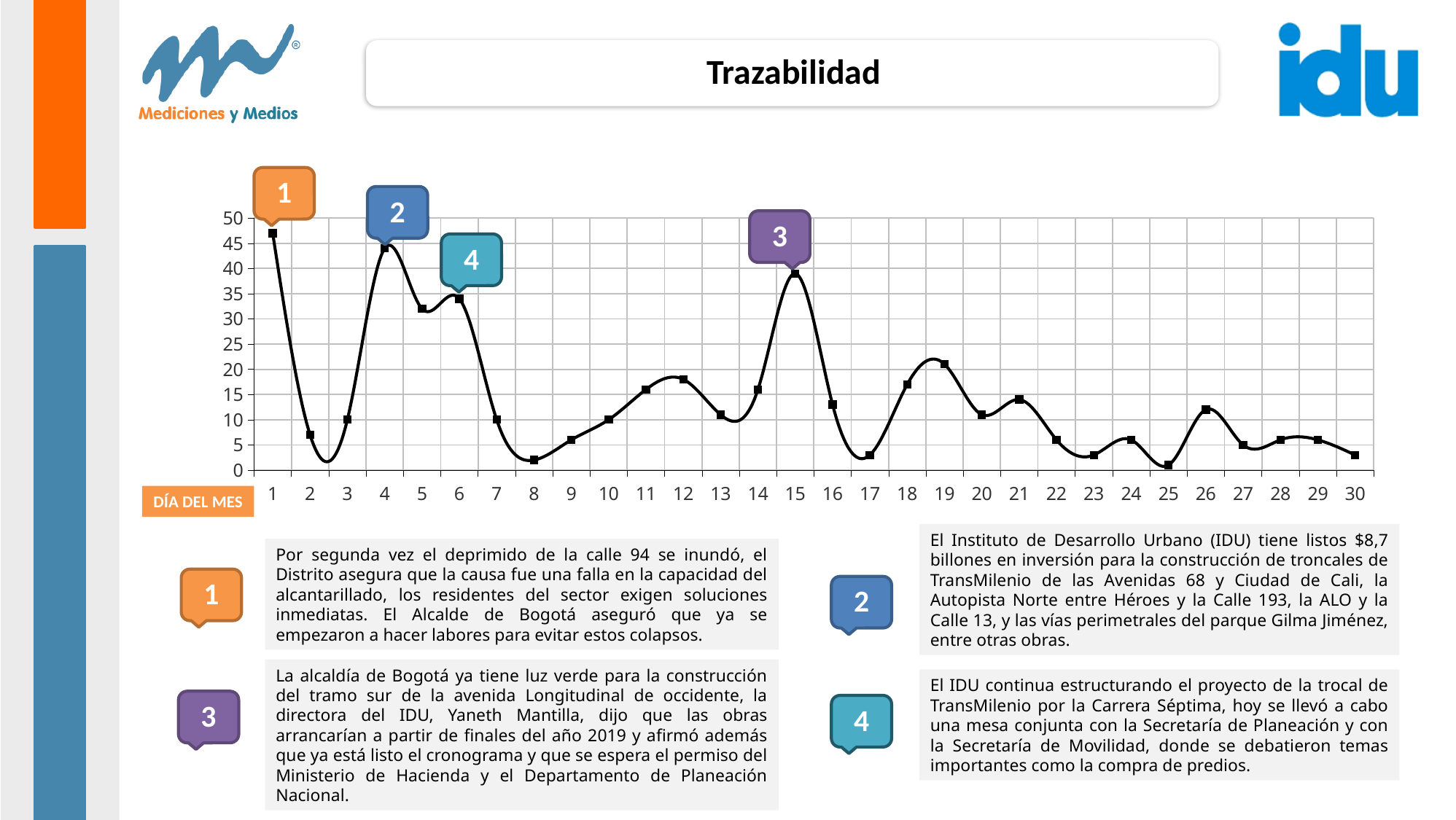
What label is shown for the x axis of the chart? DÍA DEL MES Which day has the larger value, day 4 or day 6? 4 Is the value for day 8 greater or less than 5? less How many days of the month are plotted on the x axis? 30 Is the value for day 5 greater or less than 30? greater Is the value for day 15 greater or less than 35? greater On which day of the month does the line reach its highest value? 1 What kind of chart is shown on the slide? line chart Does the line rise or fall from day 1 to day 2? fall Which day has the larger value, day 15 or day 19? 15